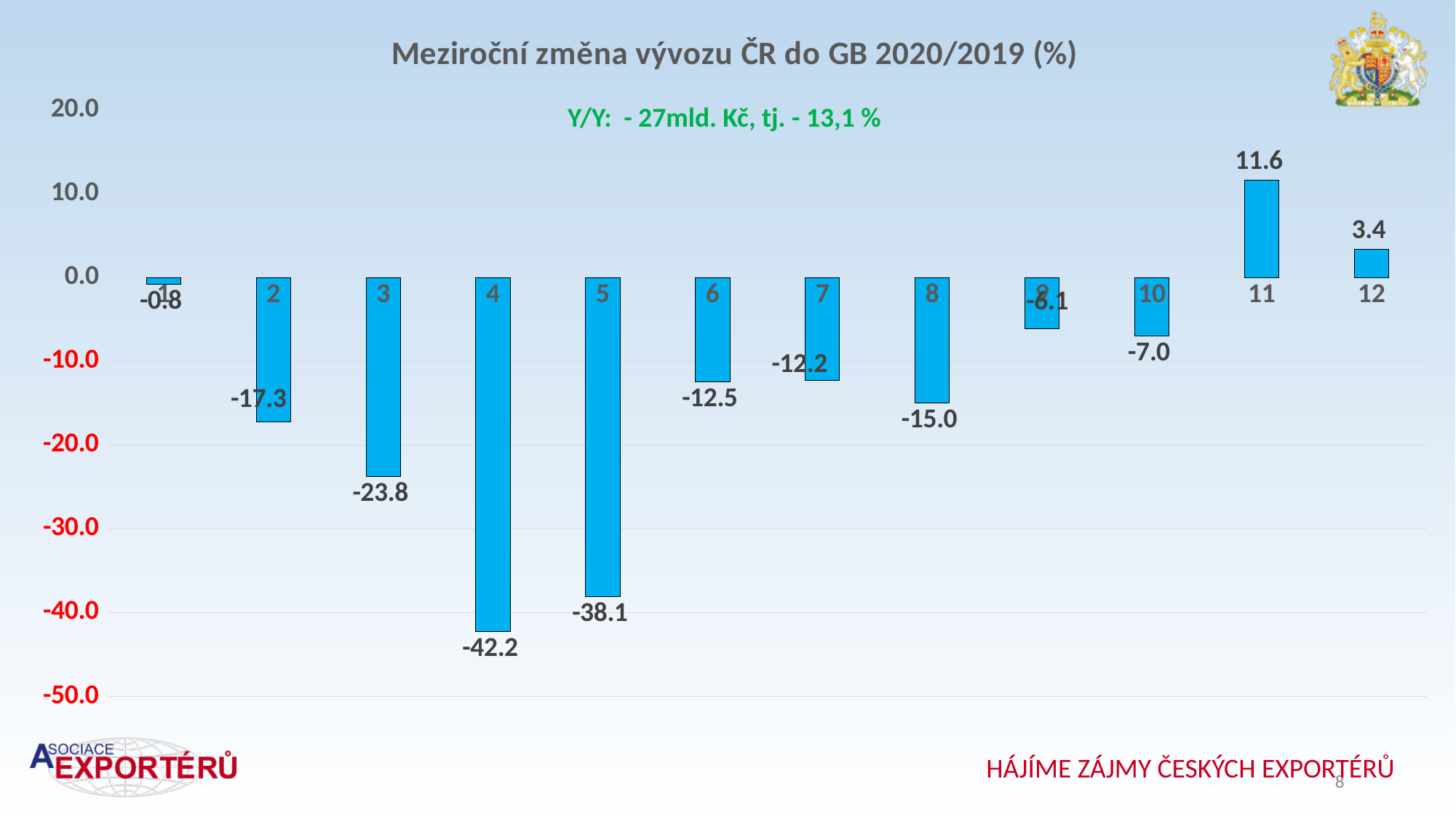
How many categories (months) are plotted in the chart? 12 Is the value for category 10 greater or less than -10.0? greater Which category has the highest value? 11 What is the difference between the values for category 4 and category 5? 4.1 What is the value for category 4? -42.2 What is the title of the chart? Meziroční změna vývozu ČR do GB 2020/2019 (%) What is the value for category 11? 11.6 Which is larger, the value for category 2 or the value for category 8? category 8 Which category has the lowest value? 4 What is the value for category 12? 3.4 What type of chart is shown on the slide? bar chart What is the value for category 3? -23.8